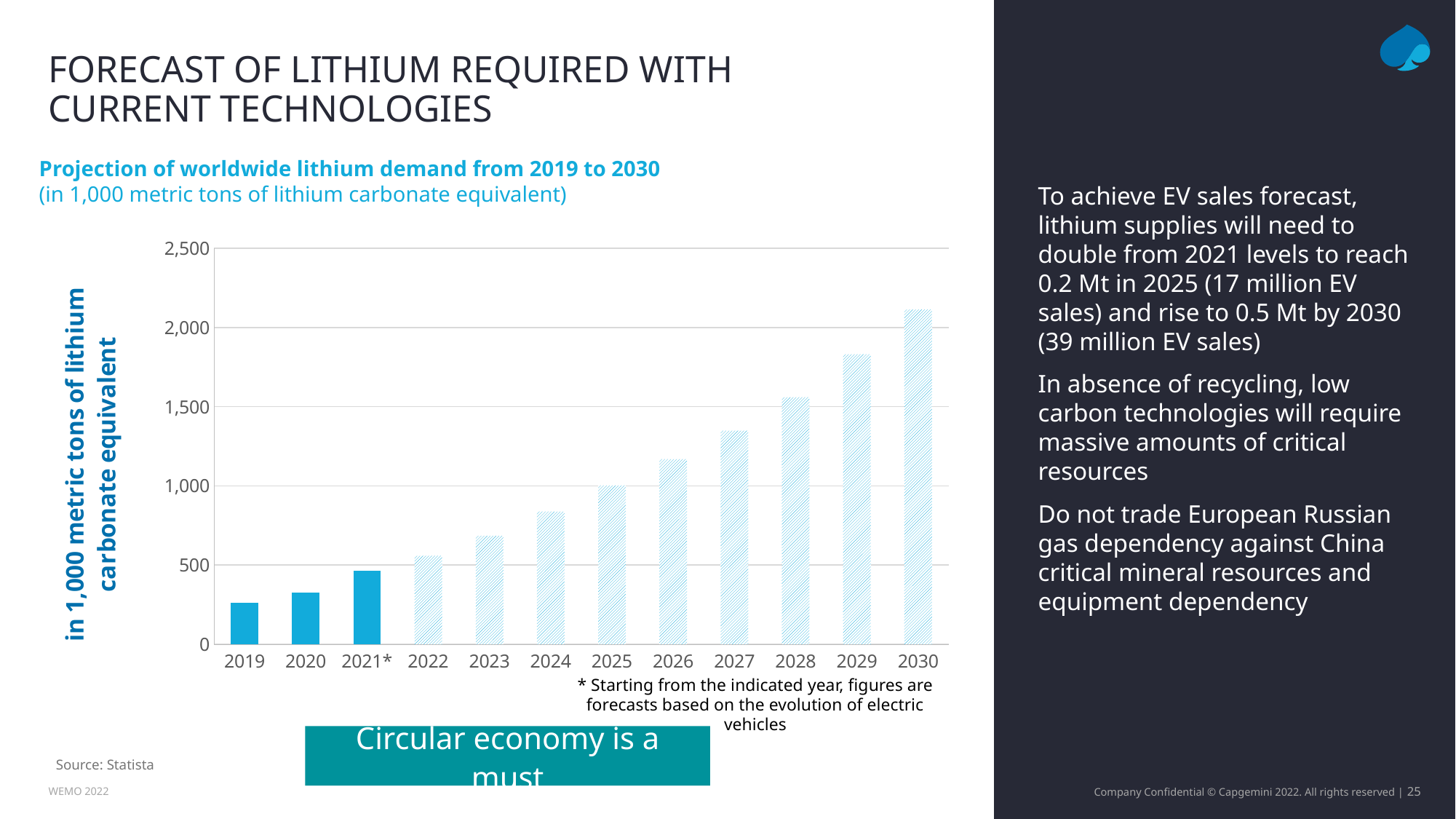
Do the values rise or fall from 2019 to 2030? rise Is the value for 2024 greater or less than 1,000? less Which is larger, the value for 2028 or the value for 2023? 2028 How many years are plotted on the x axis of the chart? 12 Is the value for 2028 greater or less than 1,500? greater Is the value for 2019 greater or less than 500? less What is the title of the chart? Projection of worldwide lithium demand from 2019 to 2030 What kind of chart is shown on the slide? bar chart Which year has the highest projected lithium demand? 2030 Which year has the lowest lithium demand in the chart? 2019